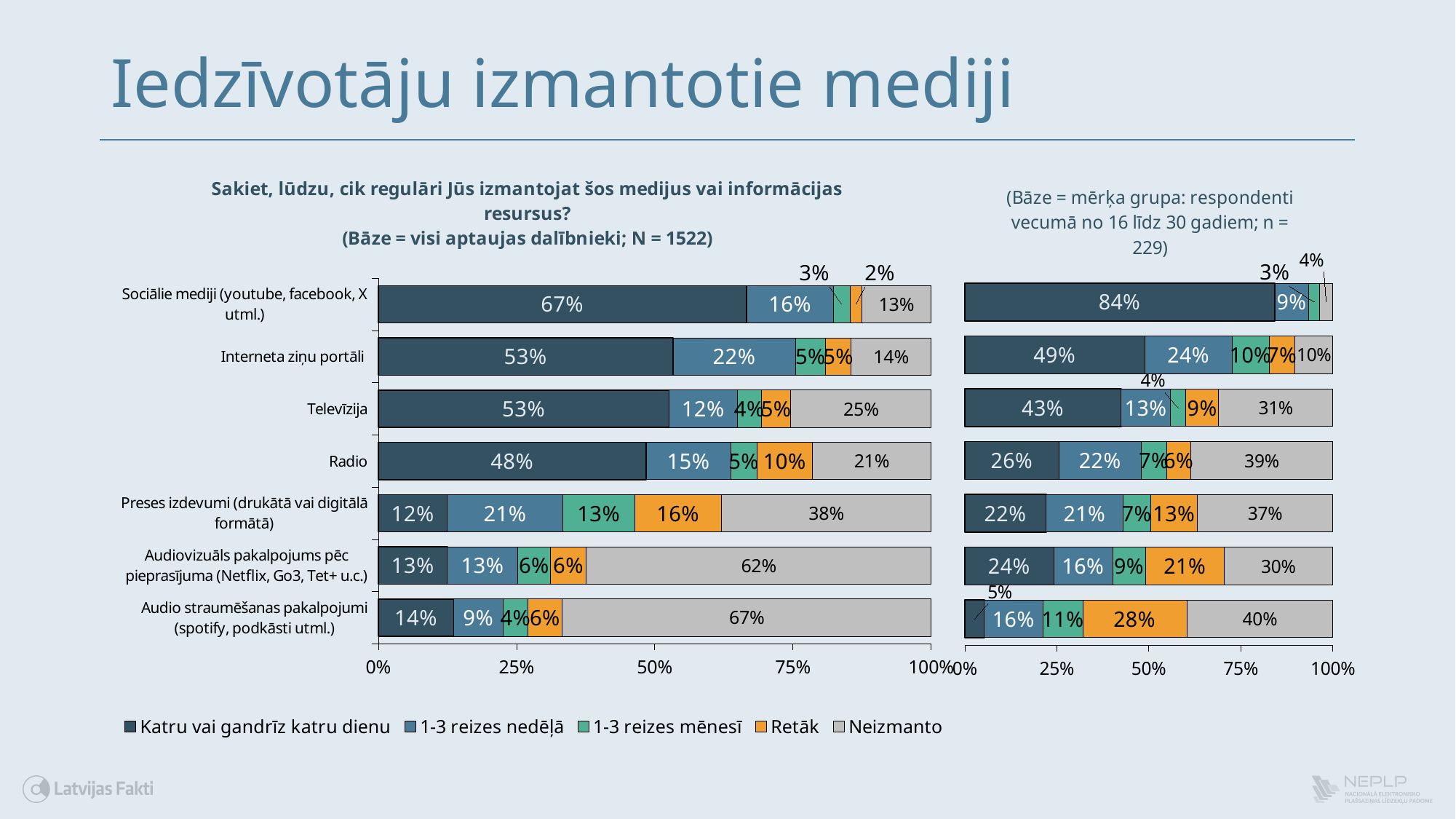
In the left chart (Bāze = visi aptaujas dalībnieki; N = 1522), what percentage of respondents use Sociālie mediji every or almost every day (Katru vai gandrīz katru dienu)? 67% In the right chart, which medium has the lowest Katru vai gandrīz katru dienu share? Audio straumēšanas pakalpojumi (spotify, podkāsti utml.) What is the difference between the Katru vai gandrīz katru dienu value for Radio in the left chart (48%) and in the right chart (26%)? 22 percentage points How many media categories are shown in the left chart? 7 In the right chart, what is the Retāk value for Audio straumēšanas pakalpojumi? 28% How many series does the legend list? 5 In the right chart, what is the Neizmanto value for Radio? 39% In the left chart, what is the Neizmanto value for Audio straumēšanas pakalpojumi? 67% What type of chart is used on this slide? Stacked bar chart In the left chart, which medium has the highest Katru vai gandrīz katru dienu share? Sociālie mediji (youtube, facebook, X utml.) In the right chart (respondents aged 16 to 30), what is the Katru vai gandrīz katru dienu value for Sociālie mediji? 84% In the left chart, which is larger: the Neizmanto value for Preses izdevumi or for Televīzija? Preses izdevumi